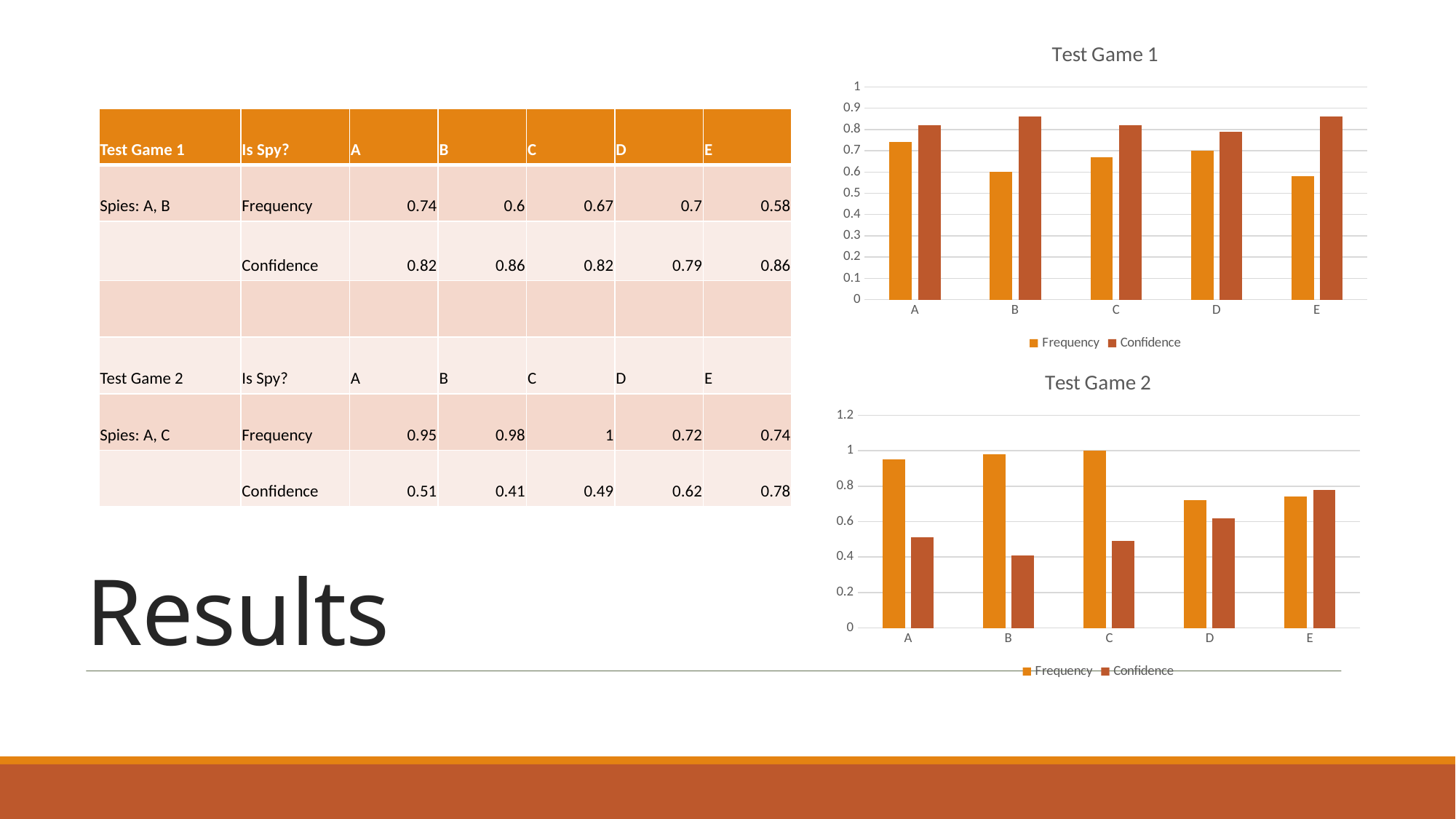
How many series does the legend of the Test Game 1 chart list? 2 In the Test Game 2 chart, which is larger for D, Frequency or Confidence? Frequency In the Test Game 1 chart, what is the Frequency value for A? 0.74 In the Test Game 1 chart, which category has the lowest Frequency? E What are the two legend entries of the Test Game 1 chart? Frequency and Confidence In the Test Game 2 chart, which category has the highest Frequency? C In the Test Game 1 chart, what is the Confidence value for D? 0.79 In the Test Game 2 chart, which category has the lowest Confidence? B In the Test Game 2 chart, what is the difference between the Frequency and Confidence values for A? 0.44 How many categories are shown on the x axis of the Test Game 1 chart? 5 In the Test Game 2 chart, is the Confidence value for B greater or less than 0.6? less What kind of chart is the Test Game 1 chart? bar chart